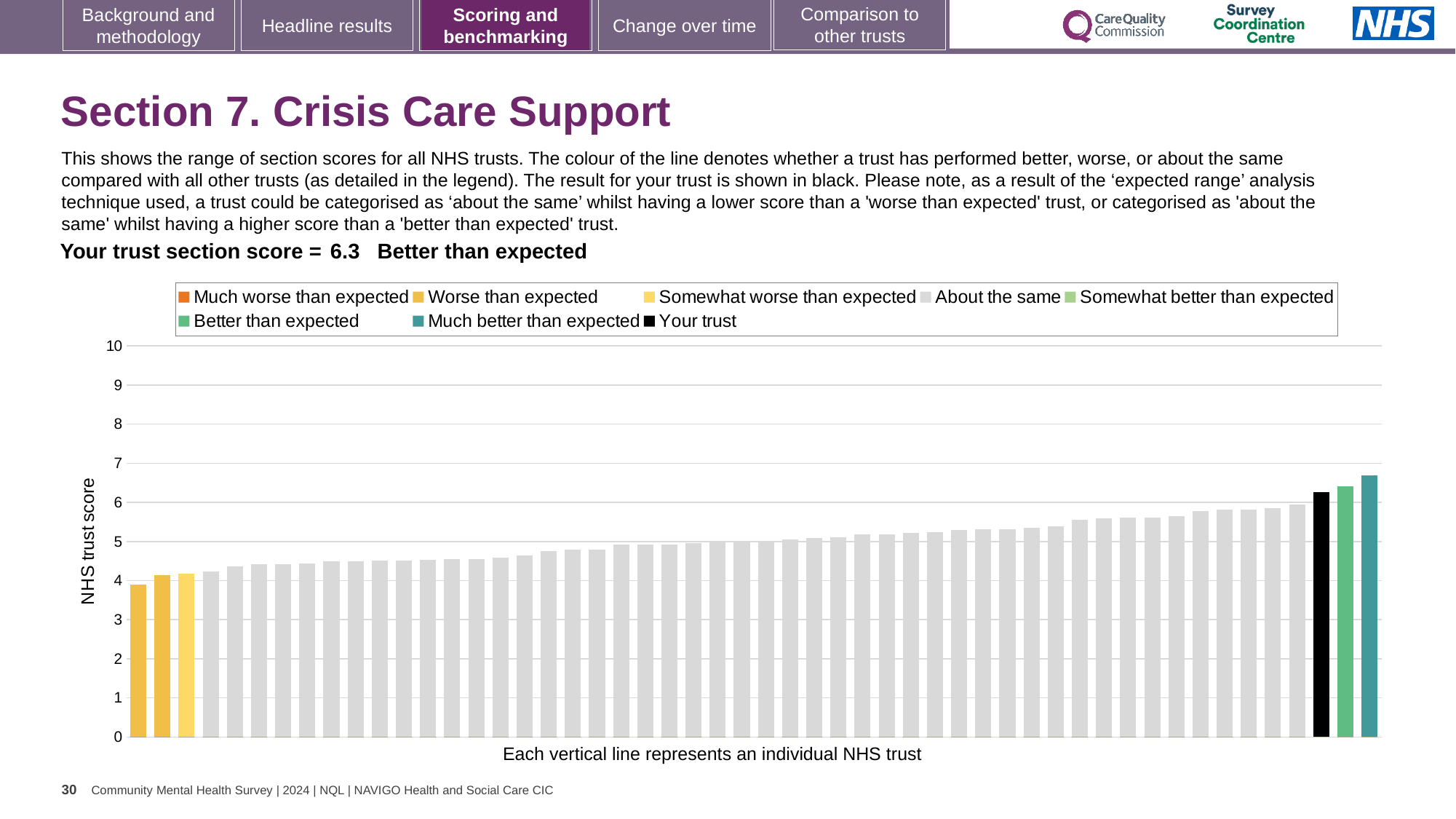
Which legend category does the shortest bar belong to? Worse than expected Is the value of the tallest bar greater or less than 7? less What is the label on the vertical axis of the chart? NHS trust score Do the bar values rise or fall from left to right along the x axis? rise What is the section score for your trust shown on the slide? 6.3 Is the value for your trust greater or less than 6? greater What kind of chart is shown on the slide? bar chart What colour is the bar representing your trust? black Is the value of the shortest bar greater or less than 5? less How many entries does the chart legend list? 8 Which legend category does the tallest bar belong to? Much better than expected Which is larger: your trust's score or the highest 'About the same' trust score? Your trust